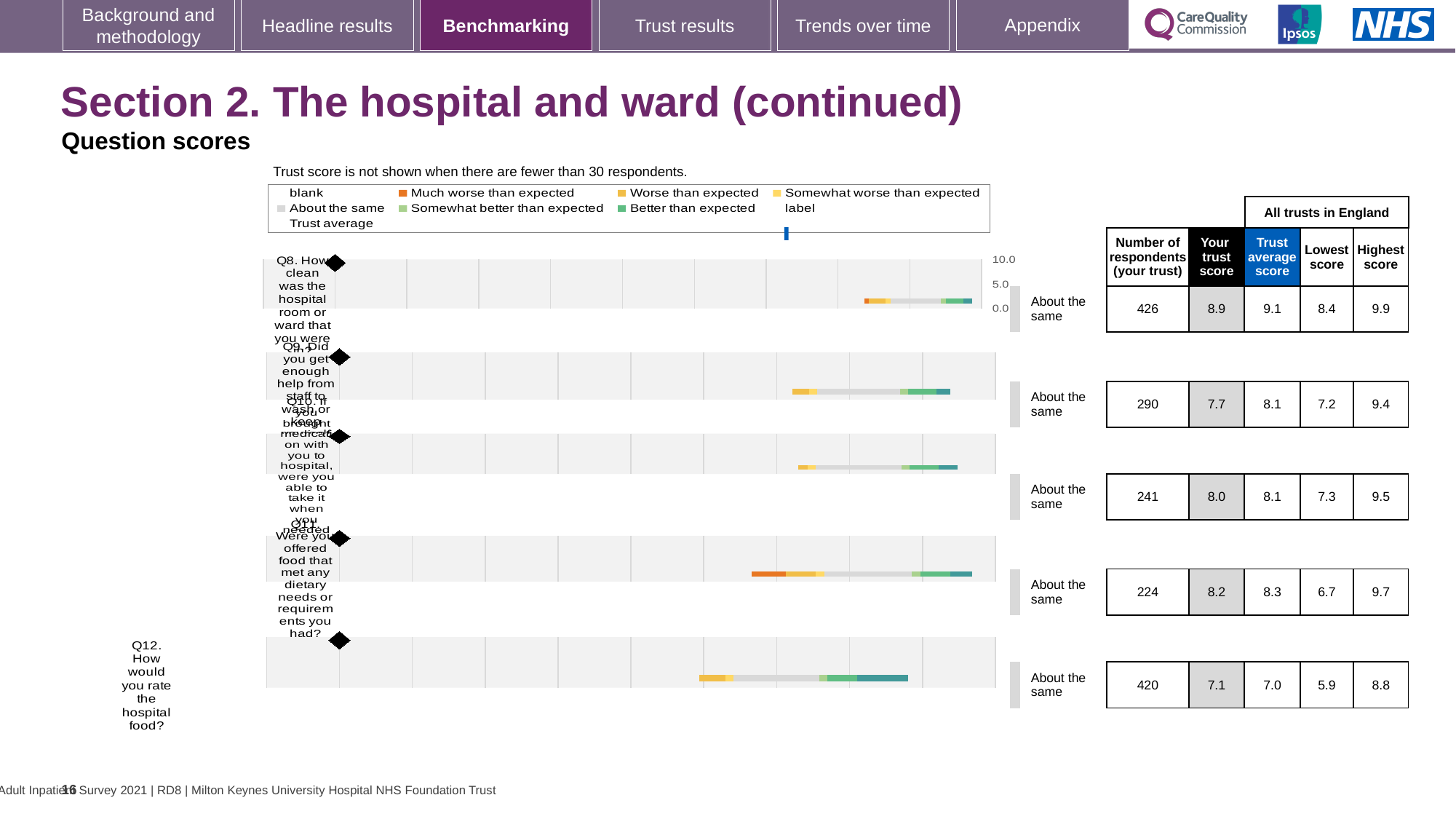
According to the note above the chart, when is the trust score not shown? When there are fewer than 30 respondents For Q12, which is larger: the 'Your trust score' or the 'Trust average score'? Your trust score For Q8, what is the difference between the highest score (9.9) and the lowest score (8.4) across all trusts in England? 1.5 Which question has the highest 'Your trust score'? Q8 What is the 'Your trust score' for Q8 (how clean was the hospital room or ward)? 8.9 What benchmark category is shown for Q11 (were you offered food that met any dietary needs)? About the same What kind of chart is used to show the question scores on this slide? bar chart What is the 'Trust average score' for Q9 (did you get enough help from staff to wash or keep yourself clean)? 8.1 What is the 'Lowest score' across all trusts in England for Q11? 6.7 How many questions (Q8 to Q12) are plotted in the chart? 5 How many respondents (your trust) are shown for Q12 (how would you rate the hospital food)? 420 Which question has the lowest 'Your trust score'? Q12